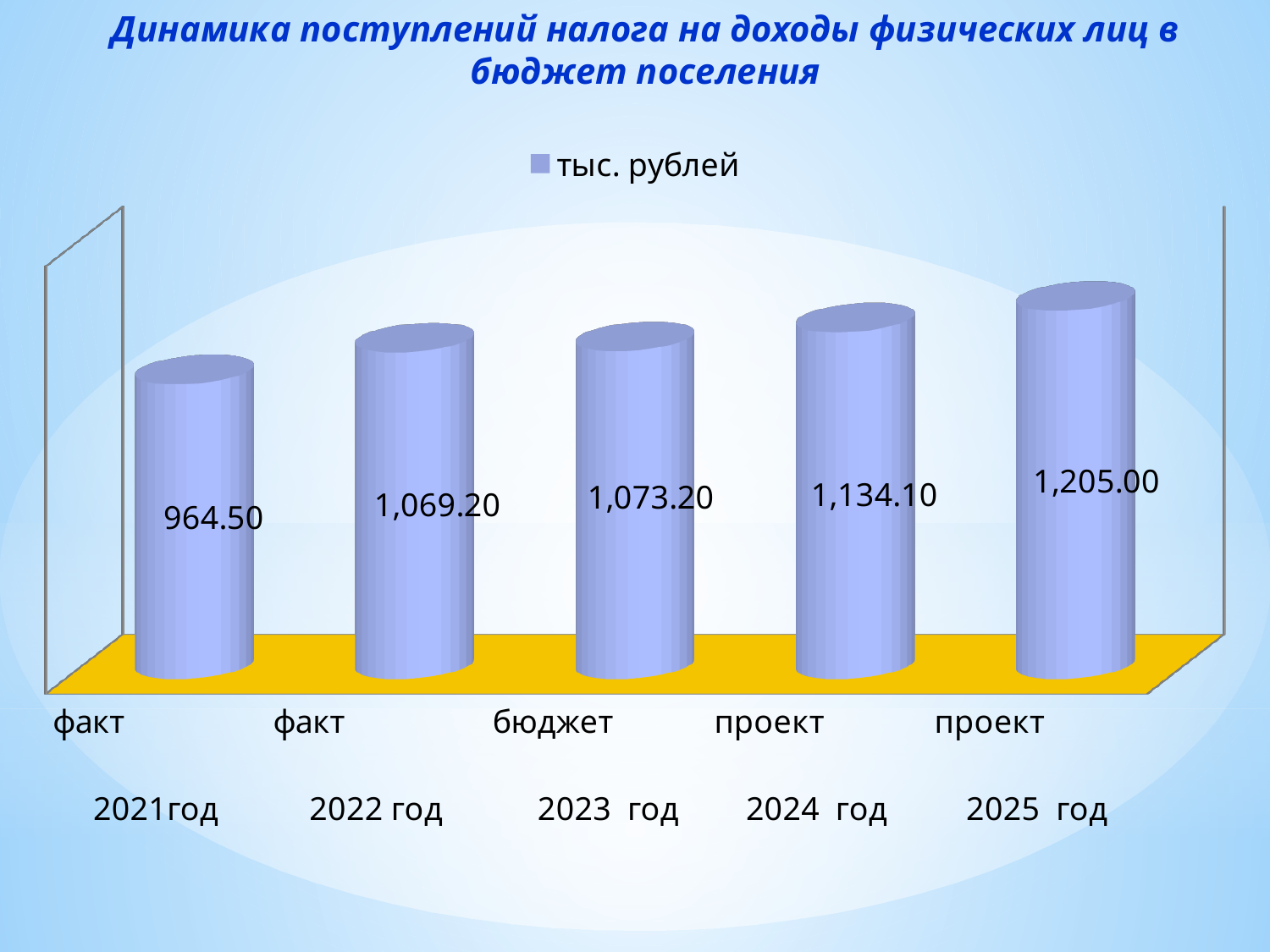
What is the difference between the values for 2025 год and 2021 год? 240.50 What is the value for 2024 год (проект)? 1,134.10 How many years are shown on the chart? 5 What is the value for 2023 год (бюджет)? 1,073.20 Which year has the lowest value? 2021 год Which is larger, the value for 2024 год or the value for 2022 год? 2024 год Do the values rise or fall from 2021 год to 2025 год? rise What is the value for 2021 год (факт)? 964.50 What kind of chart is shown on the slide? bar chart What is the difference between the values for 2024 год and 2022 год? 64.90 Which year has the highest value? 2025 год What is the value for 2025 год (проект)? 1,205.00